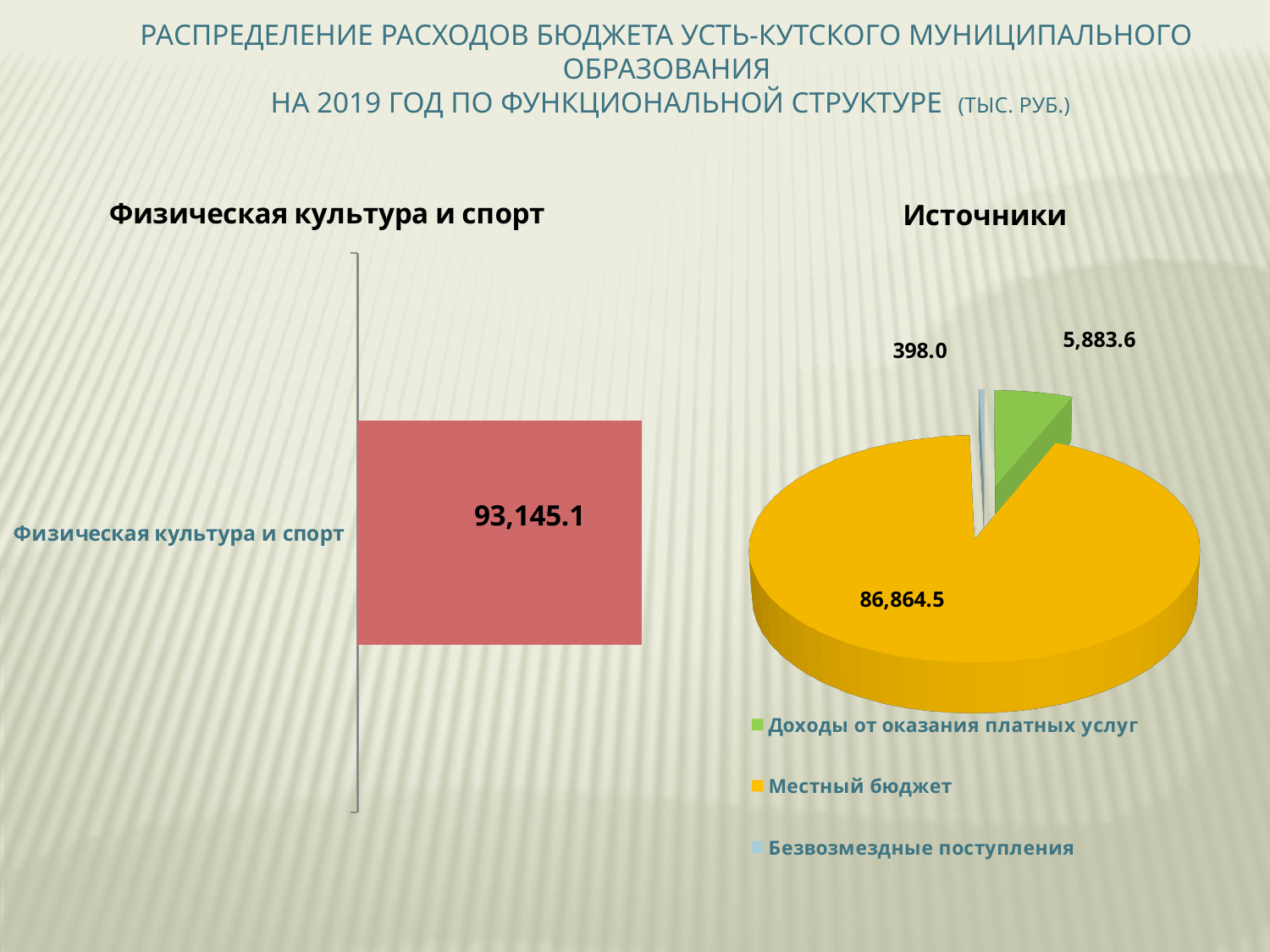
On the 'Источники' chart, what is the value for 'Доходы от оказания платных услуг'? 5,883.6 On the 'Источники' chart, what is the difference between 'Местный бюджет' and 'Доходы от оказания платных услуг'? 80,980.9 What kind of chart is the 'Физическая культура и спорт' chart? bar chart On the 'Источники' chart, what is the value for 'Безвозмездные поступления'? 398.0 On the 'Источники' chart, what is the value for 'Местный бюджет'? 86,864.5 What kind of chart is the 'Источники' chart? pie chart On the 'Источники' chart, which source has the smallest value? Безвозмездные поступления How many bars are plotted on the 'Физическая культура и спорт' chart? 1 On the 'Источники' chart, which source has the largest value? Местный бюджет On the 'Источники' chart, what colour is the 'Местный бюджет' slice? yellow How many entries does the legend of the 'Источники' chart list? 3 On the 'Физическая культура и спорт' chart, what is the value of the bar? 93,145.1